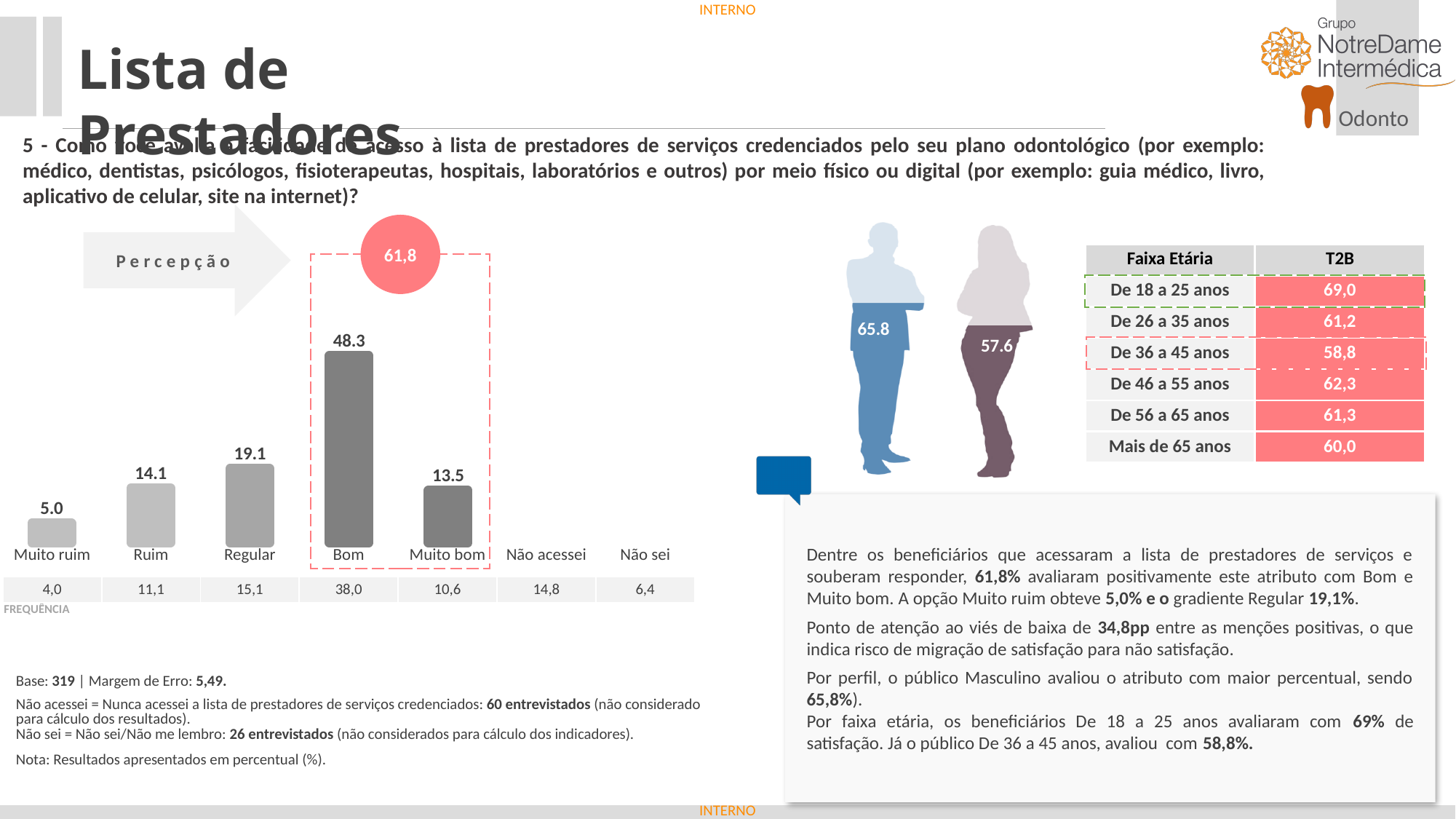
What value is shown in the pink circle above the "Bom" and "Muito bom" bars? 61,8 Which category has the lowest bar in the bar chart? Muito ruim What is the difference between the "Ruim" and "Muito ruim" values in the bar chart? 9.1 What type of chart is used to show the Percepção results? Bar chart What is the value shown for the "Muito ruim" bar in the bar chart? 5.0 Which category has the highest bar in the bar chart? Bom What is the value shown for the "Bom" bar in the bar chart? 48.3 What is the difference between the "Bom" and "Regular" values in the bar chart? 29.2 Which is larger in the bar chart, the value for "Ruim" or the value for "Muito bom"? Ruim What is the value shown for the "Regular" bar in the bar chart? 19.1 How many bars are plotted in the bar chart? 5 What is the value shown for the "Muito bom" bar in the bar chart? 13.5